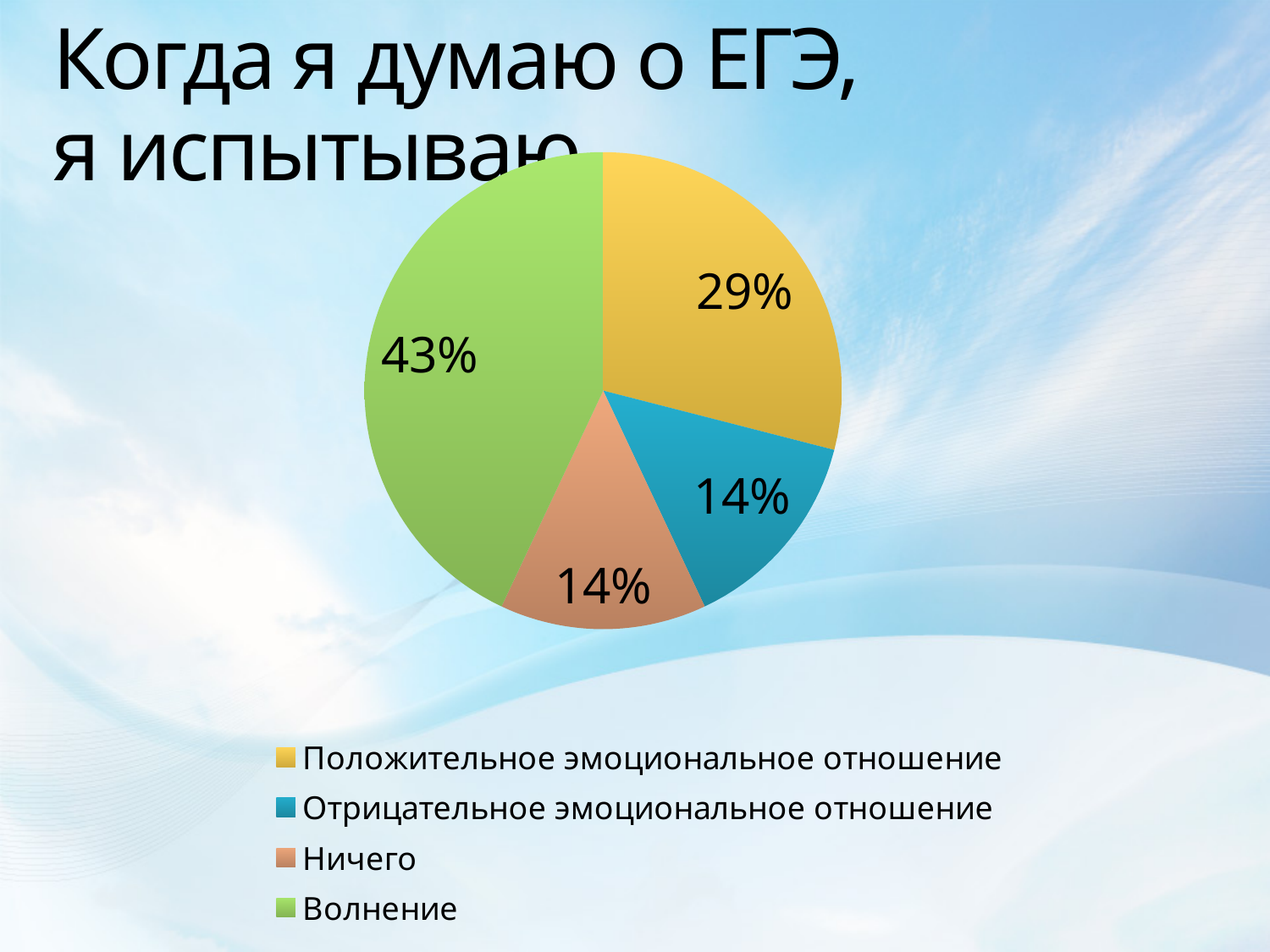
What colour is the slice for "Волнение"? Green How many slices does the pie chart have? 4 What share of the pie does "Ничего" take? 14% What is the title of the slide containing the chart? Когда я думаю о ЕГЭ, я испытываю What share of the pie does "Положительное эмоциональное отношение" take? 29% Which category has the largest slice of the pie? Волнение What is the difference between the shares for "Волнение" and "Положительное эмоциональное отношение"? 14% What kind of chart is shown on the slide? Pie chart How many entries does the legend list? 4 What share of the pie does "Отрицательное эмоциональное отношение" take? 14% Which is larger: the share for "Положительное эмоциональное отношение" or the share for "Ничего"? Положительное эмоциональное отношение